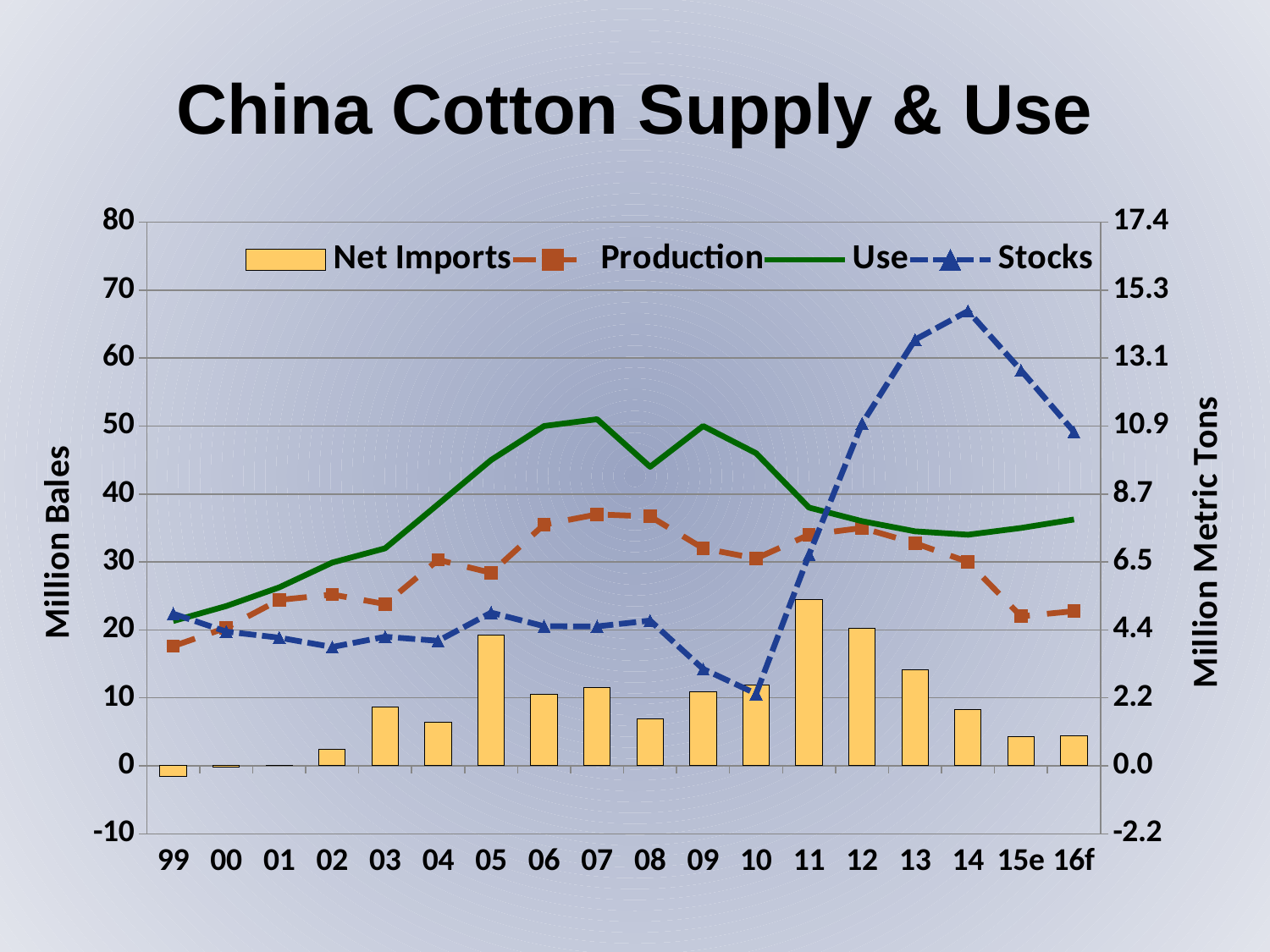
How many series does the legend list? 4 Is the Production value for 15e greater or less than 30 million bales? less How many categories are shown on the x axis? 18 Which series is plotted as bars? Net Imports Which is larger in 07, Use or Production? Use In which year are Net Imports highest? 11 What is the title of the chart? China Cotton Supply & Use What kind of chart is this? Combination bar and line chart Is the Net Imports value for 11 greater or less than 20 million bales? greater In which year are Net Imports lowest? 99 In which year are Stocks highest? 14 Do Stocks rise or fall from 10 to 14? rise